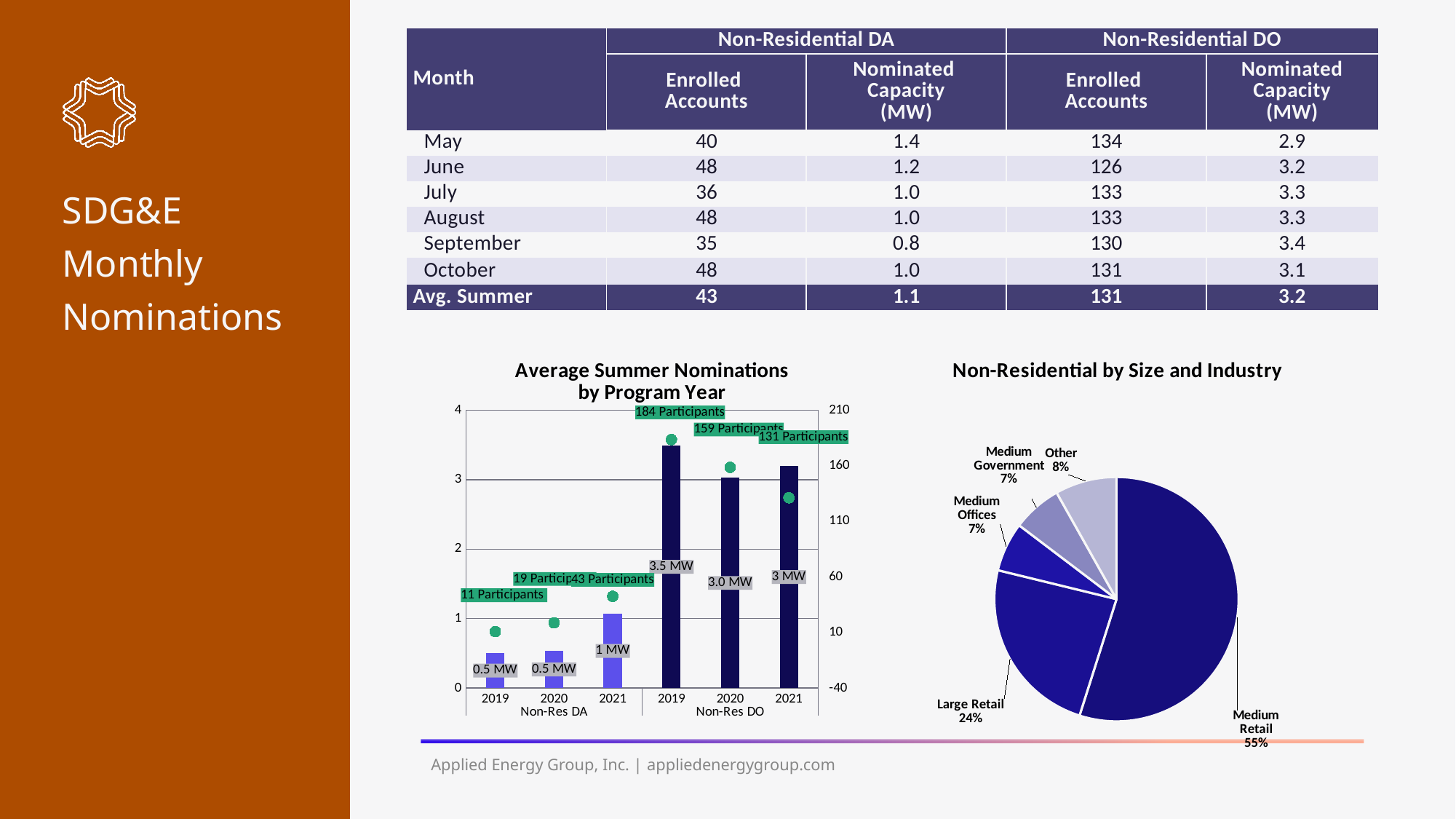
In the 'Non-Residential by Size and Industry' pie chart, what is the difference between the Large Retail and Other shares? 16% In the 'Average Summer Nominations by Program Year' chart, which bar has the highest MW value? Non-Res DO 2019 In the 'Average Summer Nominations by Program Year' chart, how many participants are shown for Non-Res DA in 2021? 43 Participants In the 'Average Summer Nominations by Program Year' chart, what is the MW value for Non-Res DO in 2019? 3.5 MW How many slices does the 'Non-Residential by Size and Industry' pie chart have? 5 In the 'Non-Residential by Size and Industry' pie chart, which slice is the largest? Medium Retail In the 'Average Summer Nominations by Program Year' chart, which is larger: the MW value for Non-Res DA 2021 or Non-Res DO 2020? Non-Res DO 2020 In the 'Non-Residential by Size and Industry' pie chart, what share does Medium Retail have? 55% In the 'Average Summer Nominations by Program Year' chart, what is the difference in participants between Non-Res DO 2019 and Non-Res DO 2021? 53 In the 'Average Summer Nominations by Program Year' chart, what is the MW value for Non-Res DA in 2019? 0.5 MW In the 'Average Summer Nominations by Program Year' chart, do the Non-Res DO participant counts rise or fall from 2019 to 2021? fall What kind of chart is 'Average Summer Nominations by Program Year'? combination chart (bars for MW with point markers for participants)